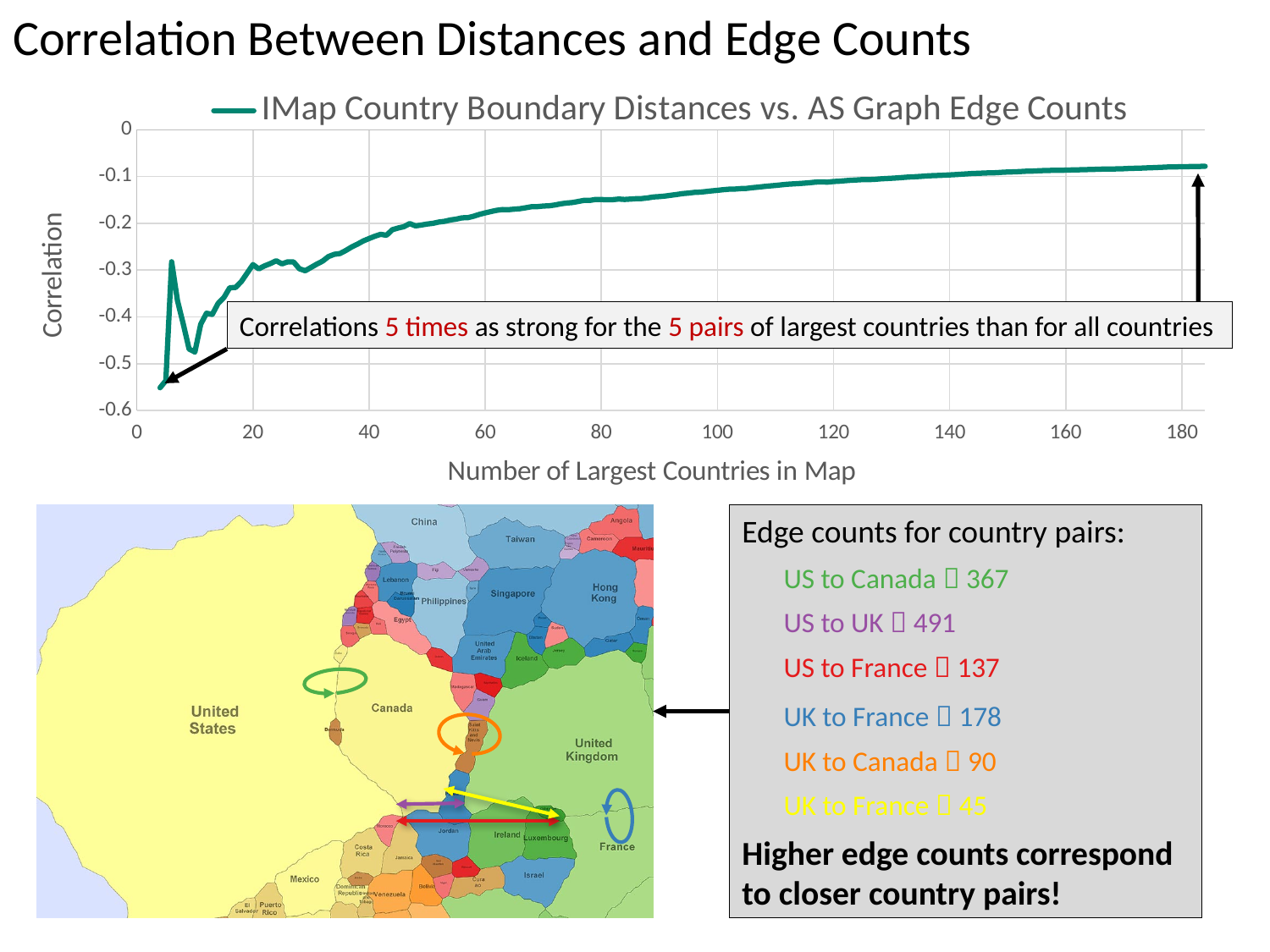
Is the correlation value at 10 largest countries greater or less than -0.4? less How many series does the chart legend list? 1 Which is larger, the correlation value at 20 largest countries or at 140 largest countries? 140 largest countries Is the correlation value at 80 largest countries greater or less than -0.2? greater Is the lowest correlation value on the chart greater or less than -0.5? less Does the correlation value generally rise or fall as the number of largest countries increases along the x axis? rise What is the name of the series shown in the chart legend? IMap Country Boundary Distances vs. AS Graph Edge Counts What is the title of the x axis of the chart? Number of Largest Countries in Map What kind of chart is shown on the slide? line chart